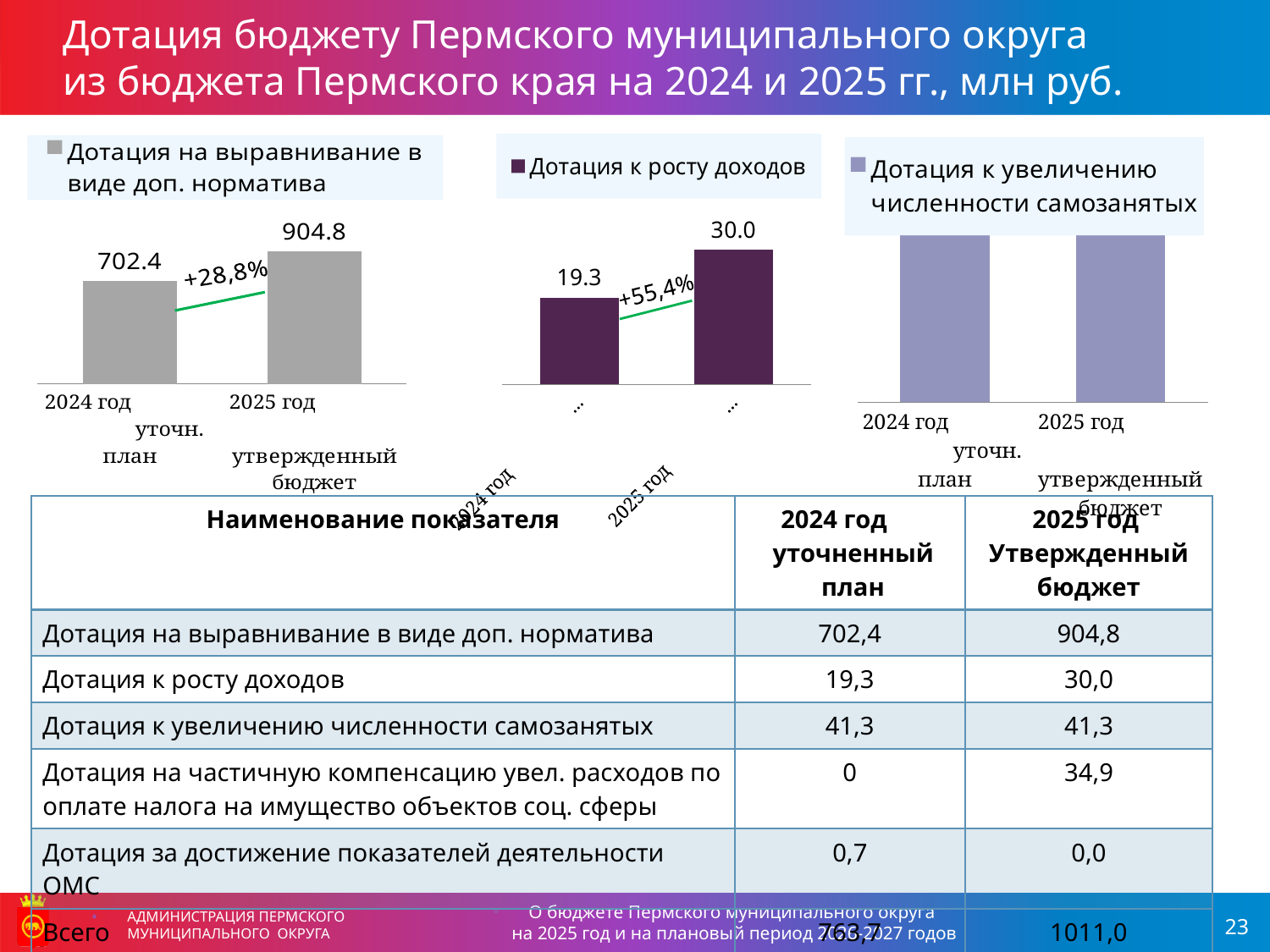
On the left chart 'Дотация на выравнивание в виде доп. норматива', what percentage change is shown between the two bars? +28,8% On the left chart 'Дотация на выравнивание в виде доп. норматива', do the values rise or fall from 2024 to 2025? rise What kind of chart is the right chart 'Дотация к увеличению численности самозанятых'? bar chart On the left chart 'Дотация на выравнивание в виде доп. норматива', what is the value for 2025 год утвержденный бюджет? 904.8 On the middle chart 'Дотация к росту доходов', what is the difference between the 2025 and 2024 values? 10.7 How many bars does the right chart 'Дотация к увеличению численности самозанятых' show? 2 On the middle chart 'Дотация к росту доходов', which bar is higher, 2024 or 2025? 2025 On the middle chart 'Дотация к росту доходов', what percentage change is shown between the two bars? +55,4% On the middle chart 'Дотация к росту доходов', what is the value of the first (2024) bar? 19.3 On the left chart 'Дотация на выравнивание в виде доп. норматива', what is the value for 2024 год уточн. план? 702.4 On the left chart 'Дотация на выравнивание в виде доп. норматива', what is the difference between the 2025 and 2024 values? 202.4 On the middle chart 'Дотация к росту доходов', what is the value of the second (2025) bar? 30.0